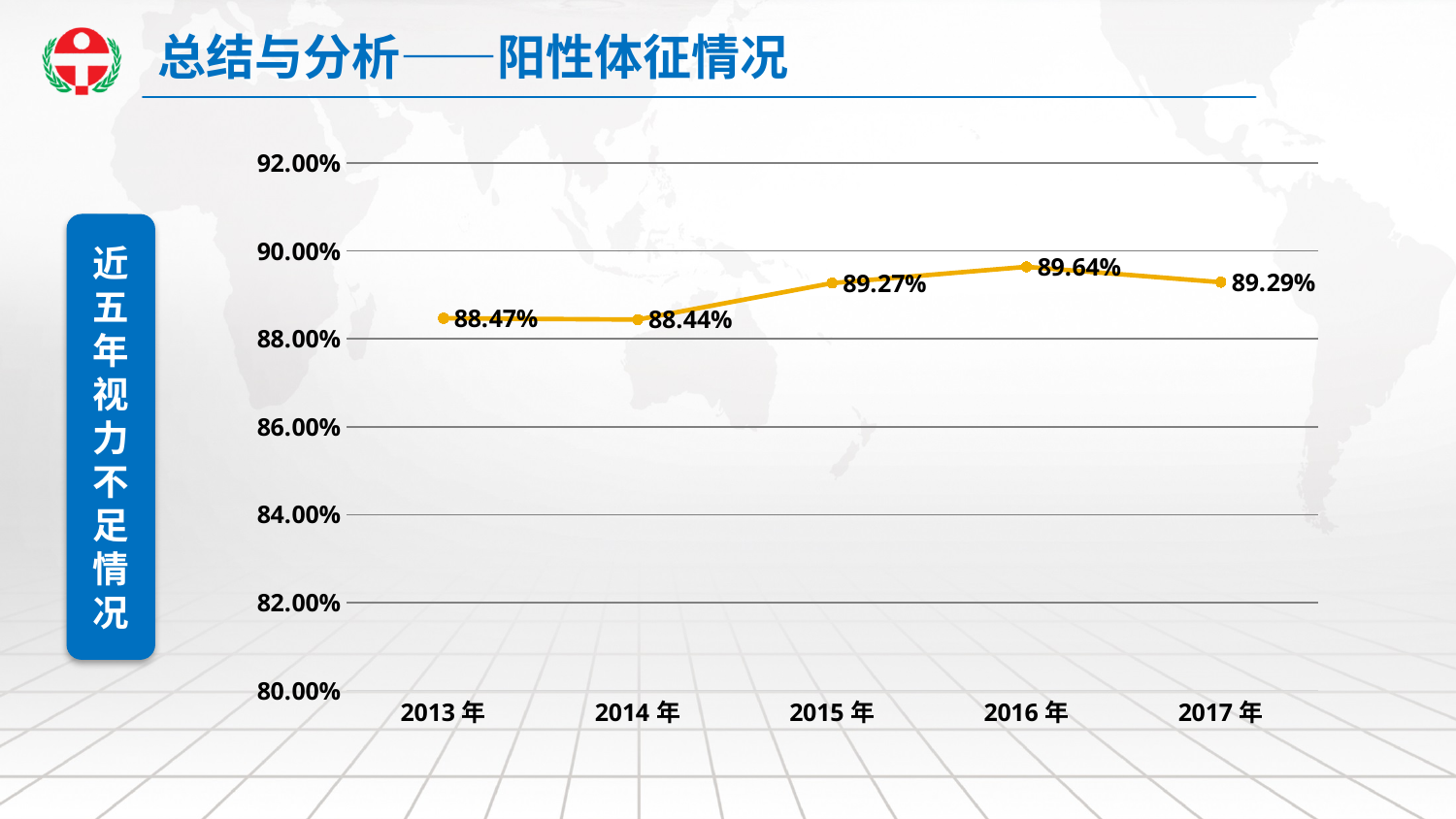
Is the value for 2016年 greater or less than 90.00%? less Which year has the highest value? 2016年 Which is larger, the value for 2015年 or the value for 2017年? 2017年 What is the value for 2015年? 89.27% What is the value for 2013年? 88.47% Which year has the lowest value? 2014年 What is the difference between the values for 2016年 and 2013年? 1.17% What kind of chart is shown on the slide? line chart What is the value for 2017年? 89.29% How many years are plotted on the chart? 5 Does the value rise or fall from 2014年 to 2016年? rise What is the text on the blue label to the left of the chart? 近五年视力不足情况